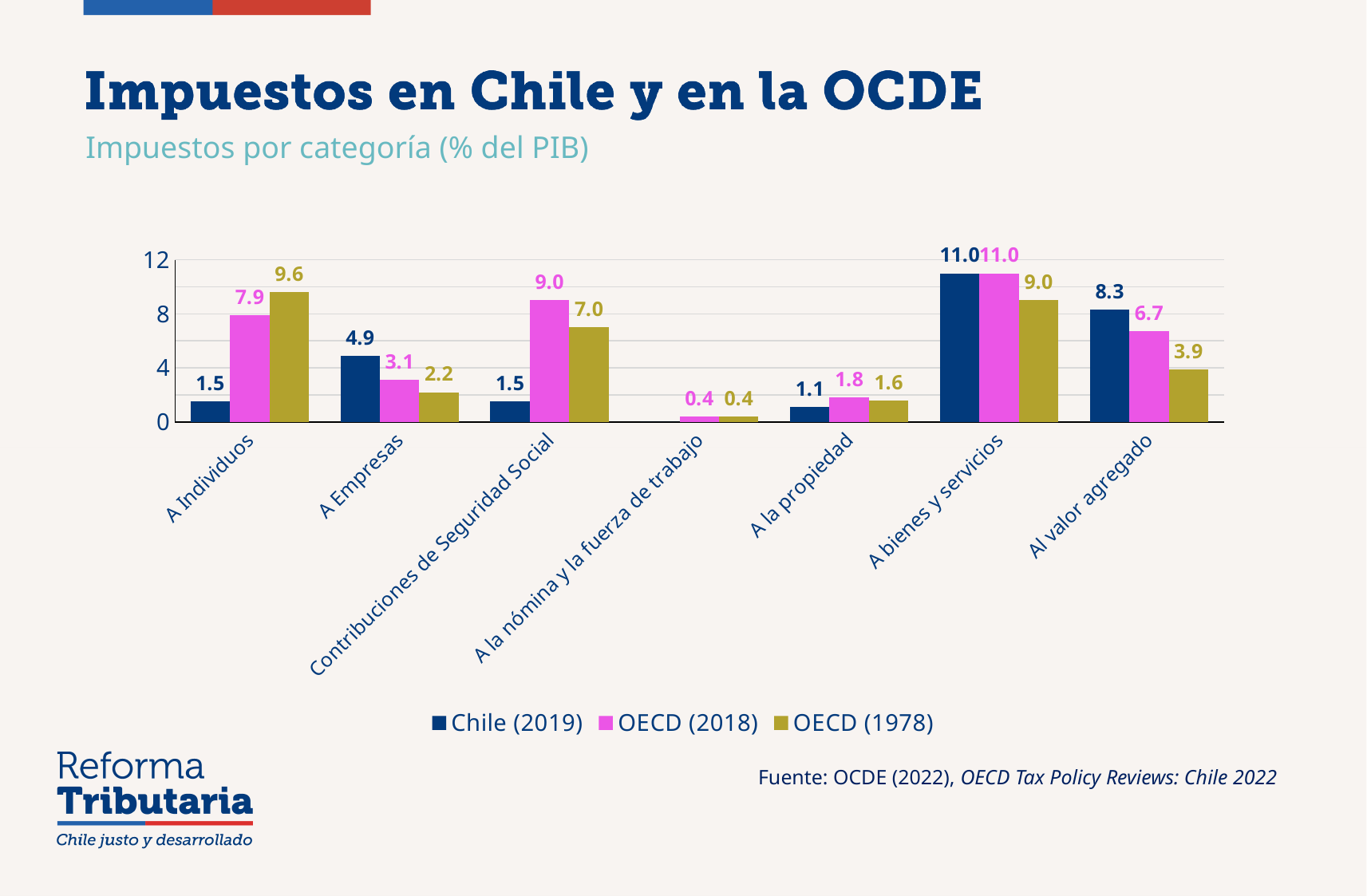
How many categories are shown on the x axis? 7 Which category has the highest Chile (2019) value? A bienes y servicios For Al valor agregado, which is larger: Chile (2019) or OECD (1978)? Chile (2019) What is the subtitle of the chart? Impuestos por categoría (% del PIB) What is the OECD (1978) value for A Individuos? 9.6 What is the difference between the Chile (2019) and OECD (2018) values for Al valor agregado? 1.6 What is the difference between the OECD (2018) and Chile (2019) values for A Individuos? 6.4 Which category has the lowest OECD (2018) value? A la nómina y la fuerza de trabajo What kind of chart is shown on the slide? Bar chart How many series does the legend list? 3 What is the OECD (2018) value for Contribuciones de Seguridad Social? 9.0 What is the Chile (2019) value for A Empresas? 4.9